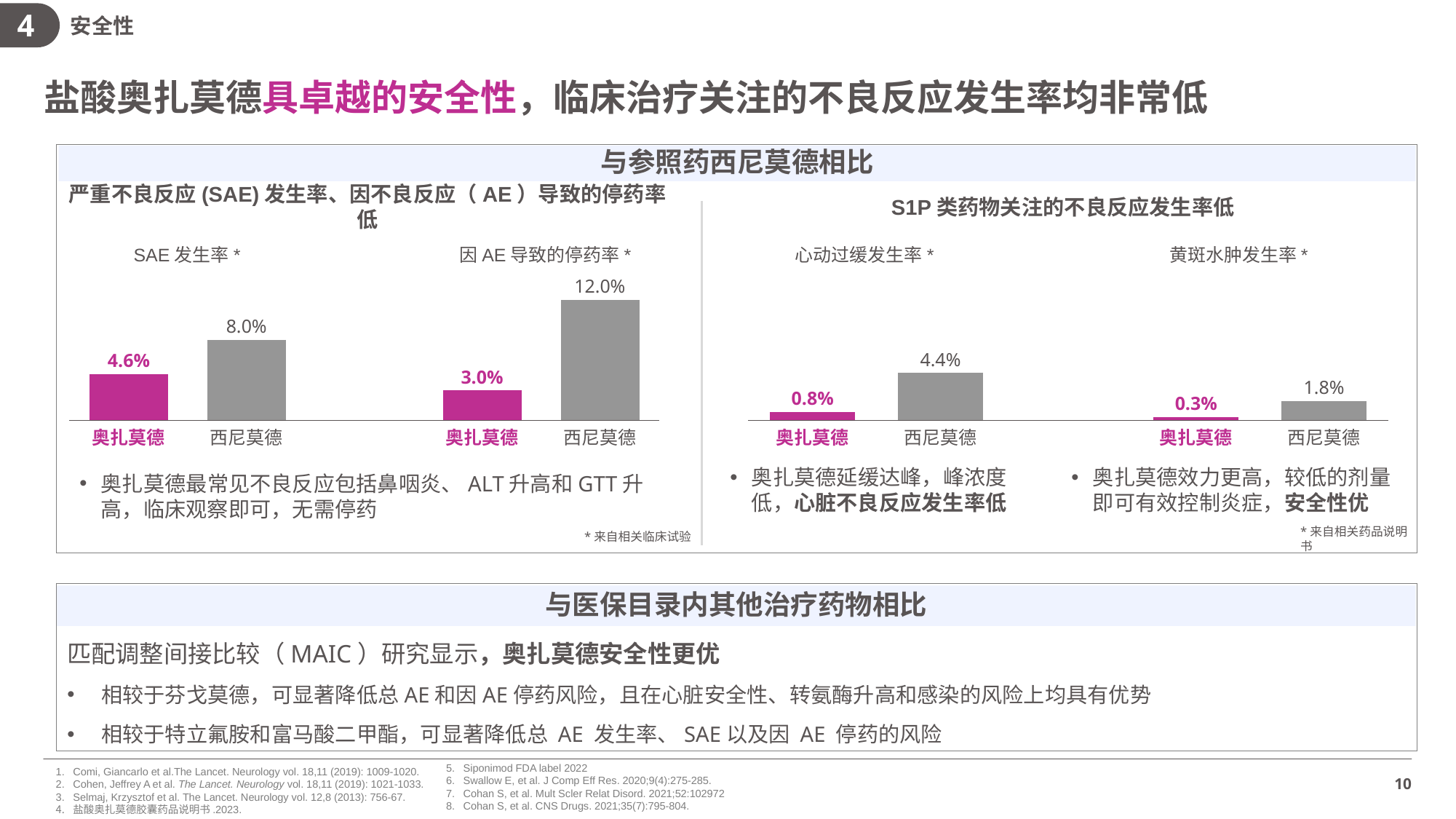
In the 黄斑水肿发生率 chart, what is the value for 奥扎莫德? 0.3% In the 因 AE 导致的停药率 chart, what is the difference between the values for 西尼莫德 and 奥扎莫德? 9.0% What kind of chart is the 心动过缓发生率 chart? Bar chart In the 因 AE 导致的停药率 chart, what is the value for 奥扎莫德? 3.0% In the 黄斑水肿发生率 chart, which drug has the higher value? 西尼莫德 In the SAE 发生率 chart, what is the value for 西尼莫德? 8.0% In the 因 AE 导致的停药率 chart, what is the value for 西尼莫德? 12.0% In the 心动过缓发生率 chart, what is the difference between the values for 西尼莫德 and 奥扎莫德? 3.6% How many bars are shown in the 黄斑水肿发生率 chart? 2 In the SAE 发生率 chart, which drug has the lower value? 奥扎莫德 In the 心动过缓发生率 chart, what is the value for 西尼莫德? 4.4% In the SAE 发生率 chart, what is the value for 奥扎莫德? 4.6%